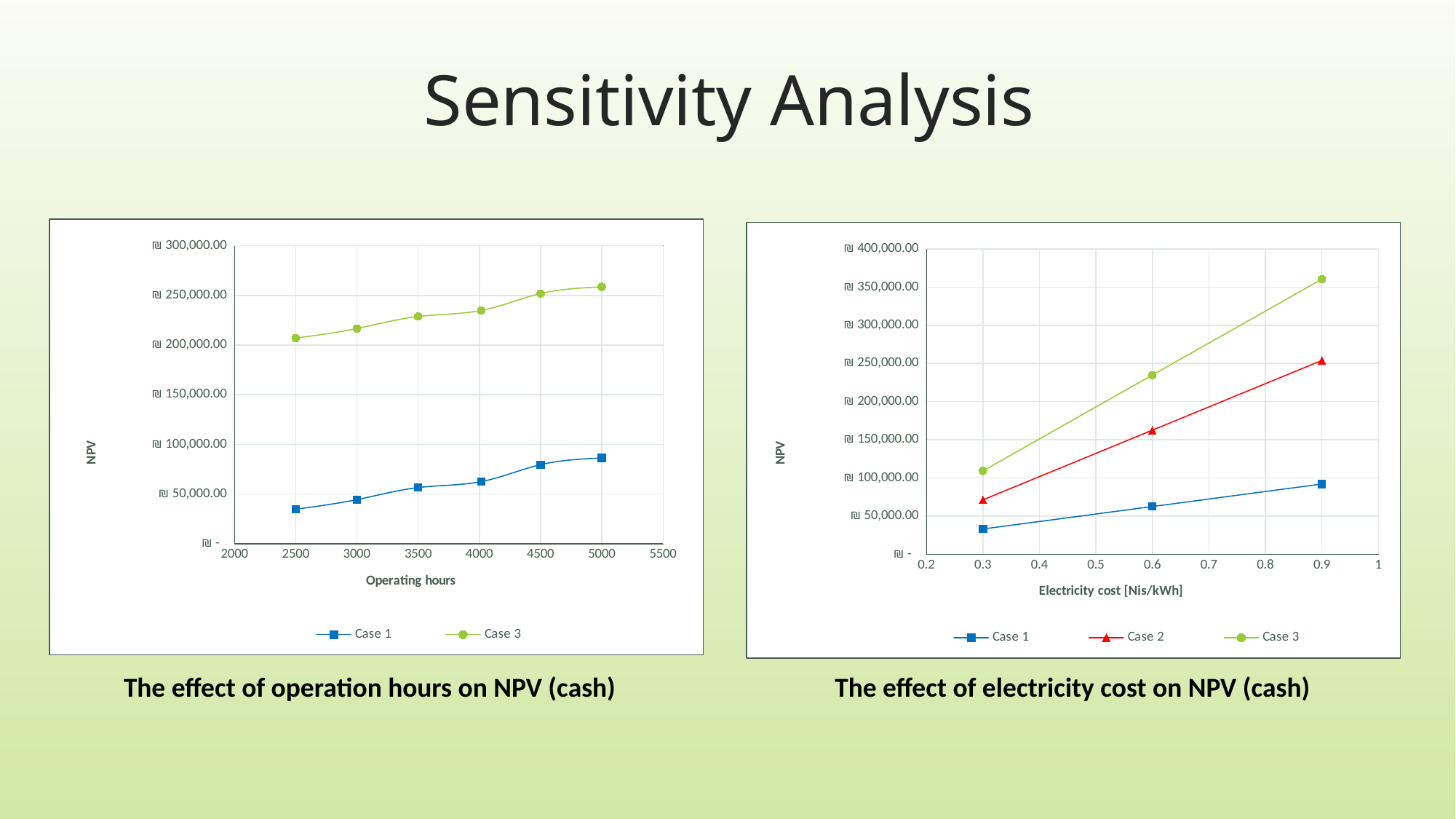
In the chart 'The effect of operation hours on NPV (cash)', how many data points are plotted for Case 3? 6 In the chart 'The effect of electricity cost on NPV (cash)', which series has the highest NPV at an electricity cost of 0.6? Case 3 In the chart 'The effect of electricity cost on NPV (cash)', which is larger at an electricity cost of 0.3: the NPV for Case 1 or for Case 2? Case 2 In the chart 'The effect of operation hours on NPV (cash)', does the NPV for Case 1 rise or fall as operating hours increase? Rise In the chart 'The effect of electricity cost on NPV (cash)', is the NPV for Case 3 at an electricity cost of 0.9 greater or less than ₪ 350,000.00? greater In the chart 'The effect of electricity cost on NPV (cash)', how many series does the legend list? 3 In the chart 'The effect of operation hours on NPV (cash)', is the NPV for Case 1 at 5000 operating hours greater or less than ₪ 100,000.00? less In the chart 'The effect of electricity cost on NPV (cash)', does the NPV for Case 3 rise or fall as electricity cost increases? Rise What kind of chart is 'The effect of operation hours on NPV (cash)'? Line chart In the chart 'The effect of operation hours on NPV (cash)', is the NPV for Case 3 at 2500 operating hours greater or less than ₪ 200,000.00? greater In the chart 'The effect of operation hours on NPV (cash)', how many series does the legend list? 2 In the chart 'The effect of electricity cost on NPV (cash)', how many data points are plotted for Case 2? 3